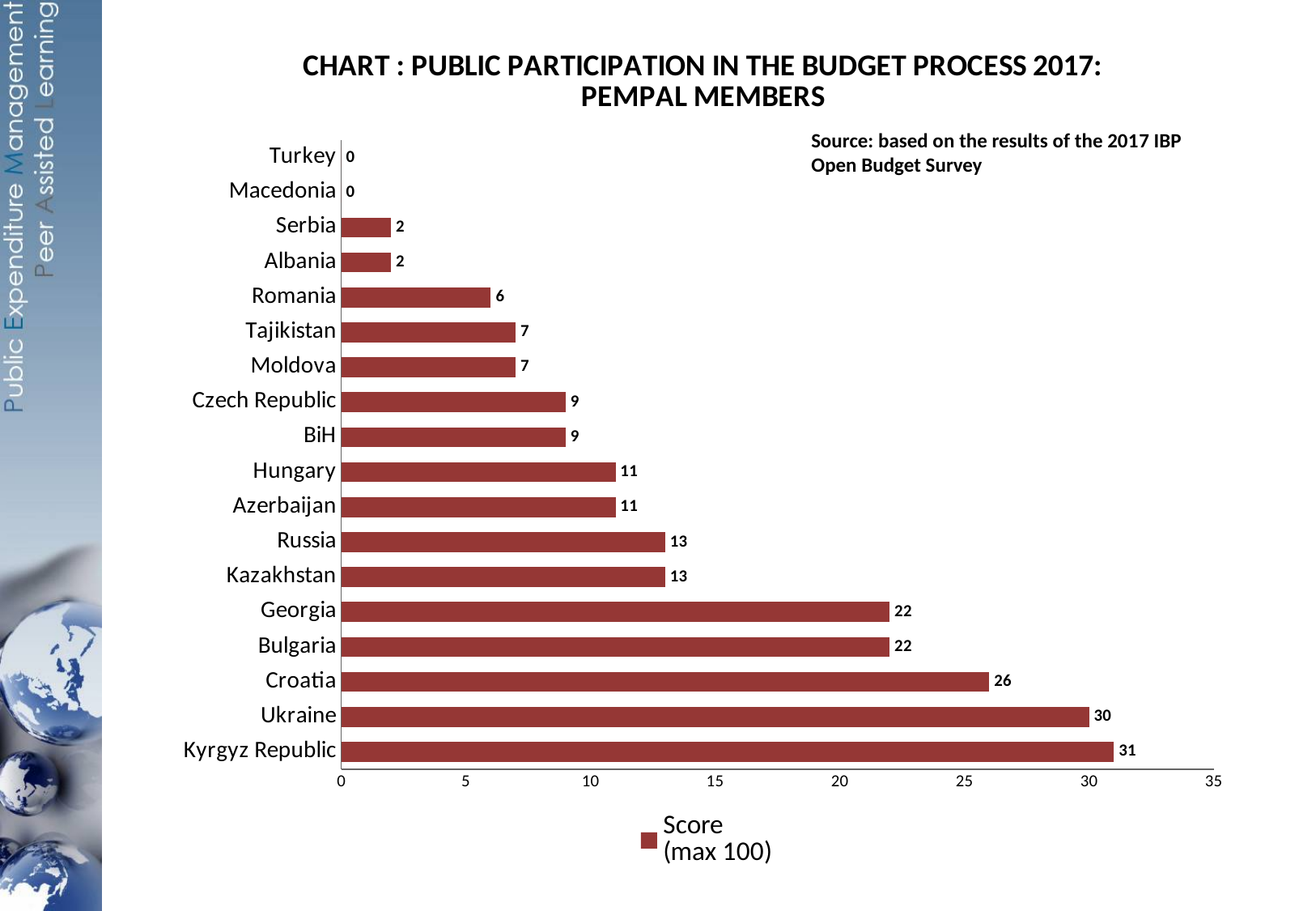
Which has a higher score, Hungary or Tajikistan? Hungary What is the difference between the scores of Croatia and Russia? 13 What kind of chart is shown? Bar chart What is the score for Romania? 6 What is the score for Ukraine? 30 What is the score for Georgia? 22 How many series does the legend list? 1 How many countries are shown in the chart? 18 What is the maximum value shown on the horizontal axis? 35 What is the legend entry for the series? Score (max 100) Which countries have a score of 0? Turkey and Macedonia Which country has the highest score? Kyrgyz Republic